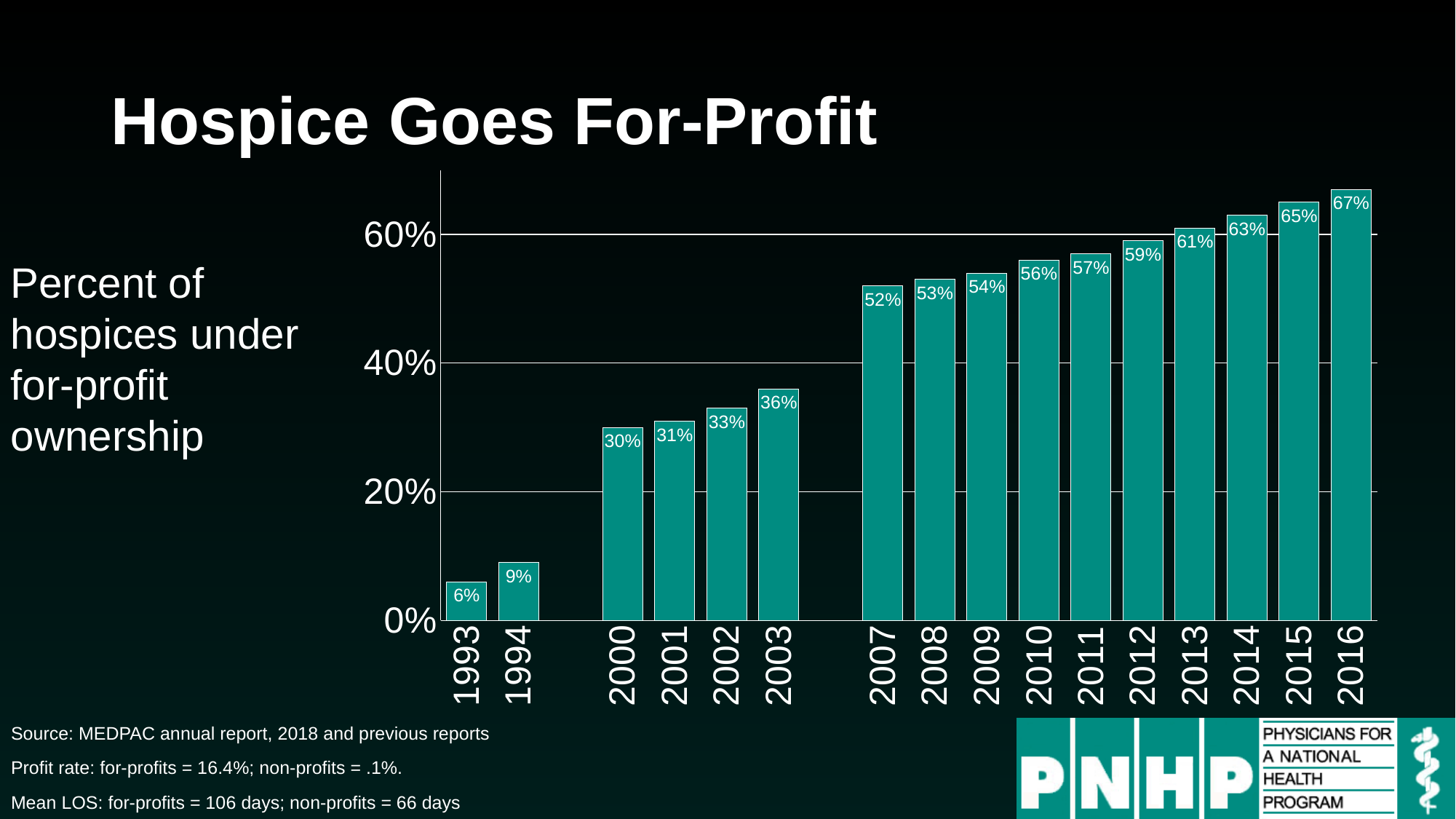
Which year has the lowest percent of for-profit hospices? 1993 Which year has the highest percent of for-profit hospices? 2016 Which year has a larger value, 2002 or 2010? 2010 Is the value for 2013 greater or less than 60%? greater What is the value shown for 2007? 52% What is the difference between the values for 2003 and 2000? 6% What is the difference between the values for 2016 and 1993? 61% Do the values rise or fall from 1993 to 2016? Rise How many years are shown on the x axis? 16 What kind of chart is shown on the slide? Bar chart What percent of hospices were under for-profit ownership in 2016? 67% What is the value shown for 1993? 6%